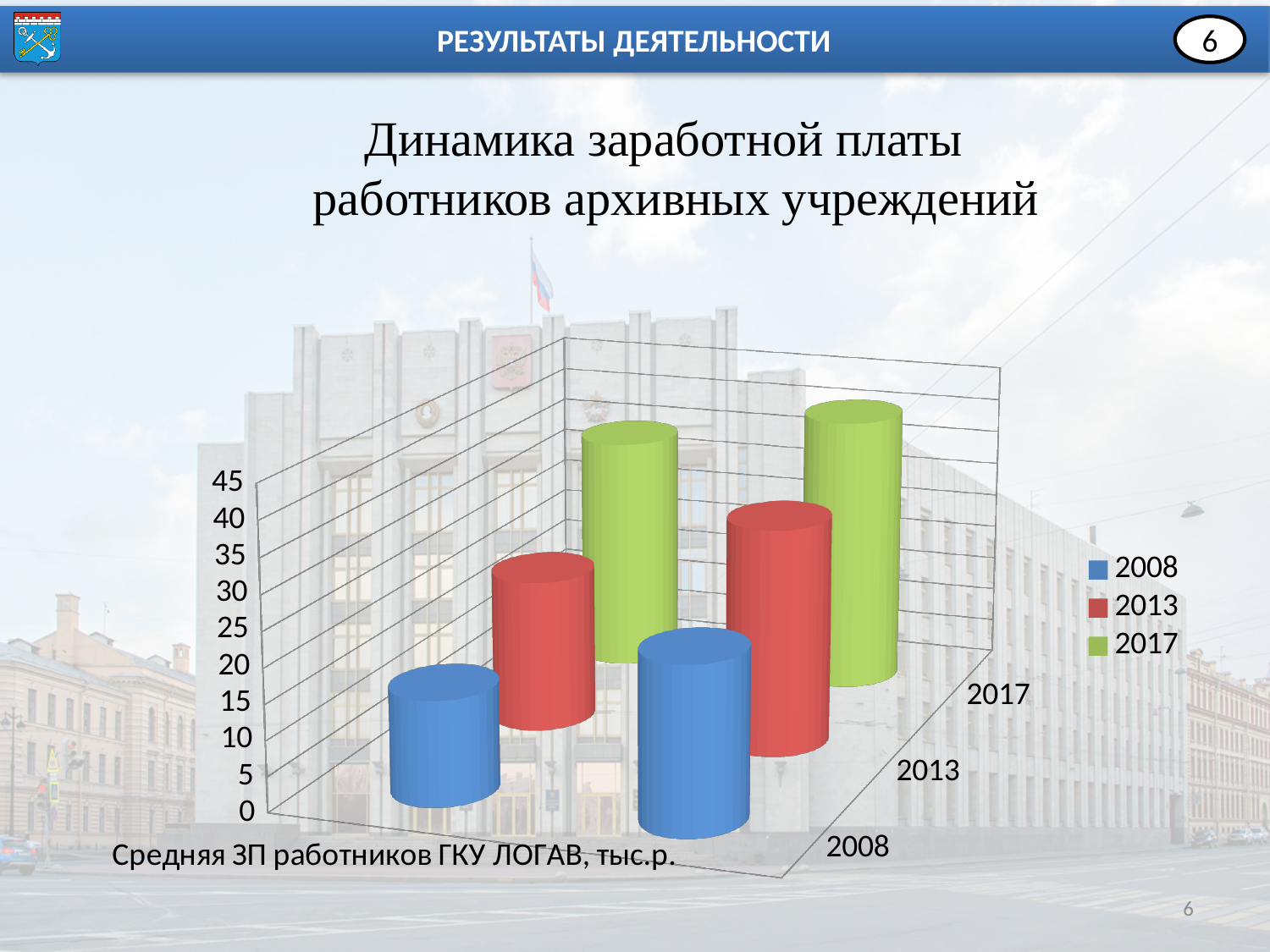
How many groups of bars are plotted in the chart? 2 Is the 2017 value in the right group of bars greater or less than 20? greater What is the title of the chart on the slide? Динамика заработной платы работников архивных учреждений Which years are listed in the chart legend? 2008, 2013, 2017 In the left group of bars, which series has the highest value? 2017 Within the left group of bars, do the values rise or fall from 2008 to 2017? rise In the right group of bars, which is larger: the 2008 value or the 2017 value? 2017 What kind of chart is shown on the slide? bar chart Is the 2008 value in the left group of bars greater or less than 30? less How many series does the chart legend list? 3 Within the right group of bars, do the values rise or fall from 2008 to 2017? rise In the left group of bars, which series has the lowest value? 2008